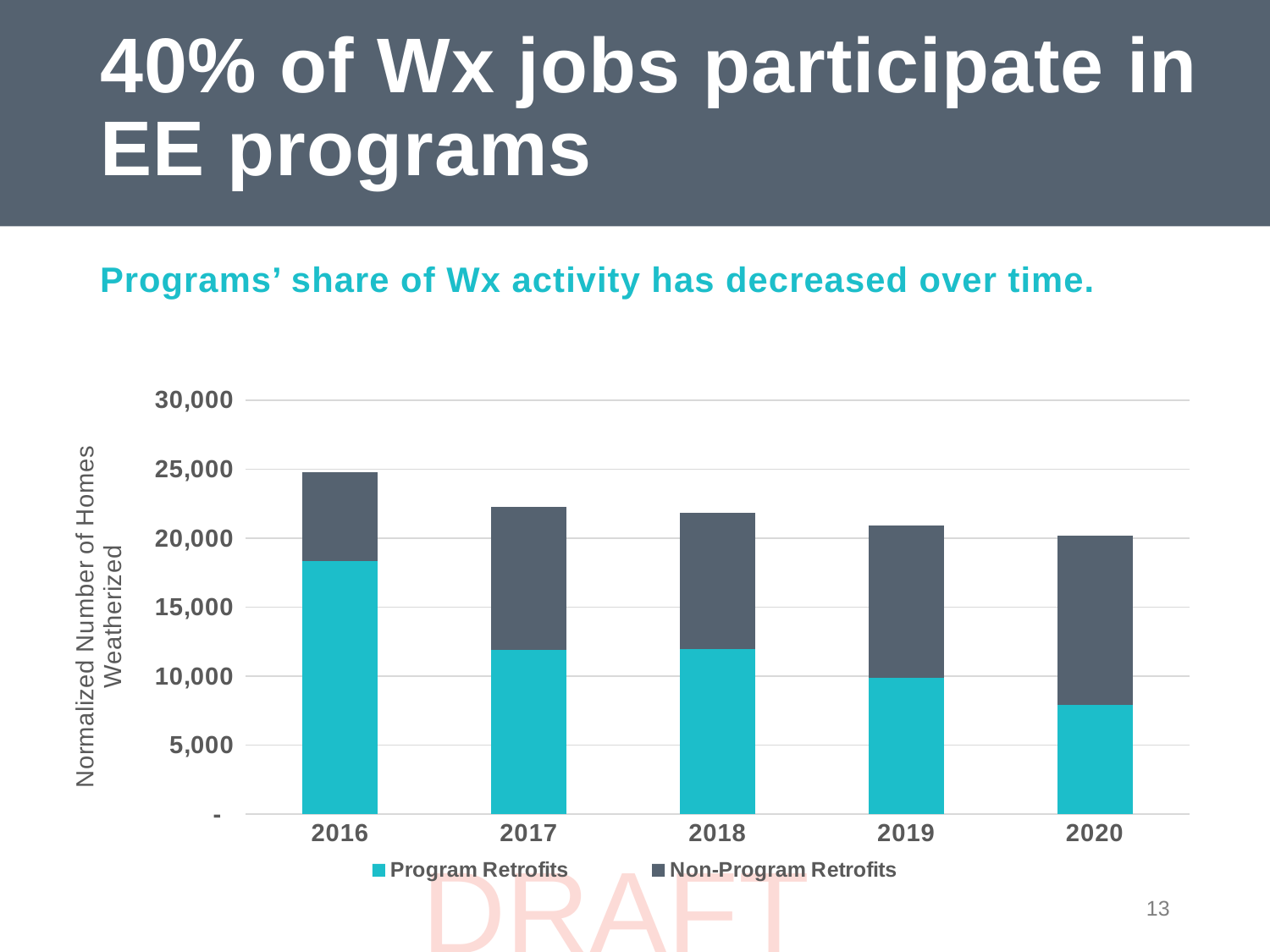
Is the value for Program Retrofits in 2016 greater or less than 15,000? greater How many years are shown on the x axis of the chart? 5 Which year has the tallest total stacked bar? 2016 What kind of chart is shown on the slide? Stacked bar chart Which year has the highest value for Program Retrofits? 2016 Which year has the lowest value for Program Retrofits? 2020 Which year has the lowest value for Non-Program Retrofits? 2016 Do the Program Retrofits values rise or fall from 2016 to 2020? Fall Which is larger: Program Retrofits in 2016 or Program Retrofits in 2020? Program Retrofits in 2016 How many series does the chart's legend list? 2 Is the value for Program Retrofits in 2020 greater or less than 10,000? less What is the label on the chart's y axis? Normalized Number of Homes Weatherized